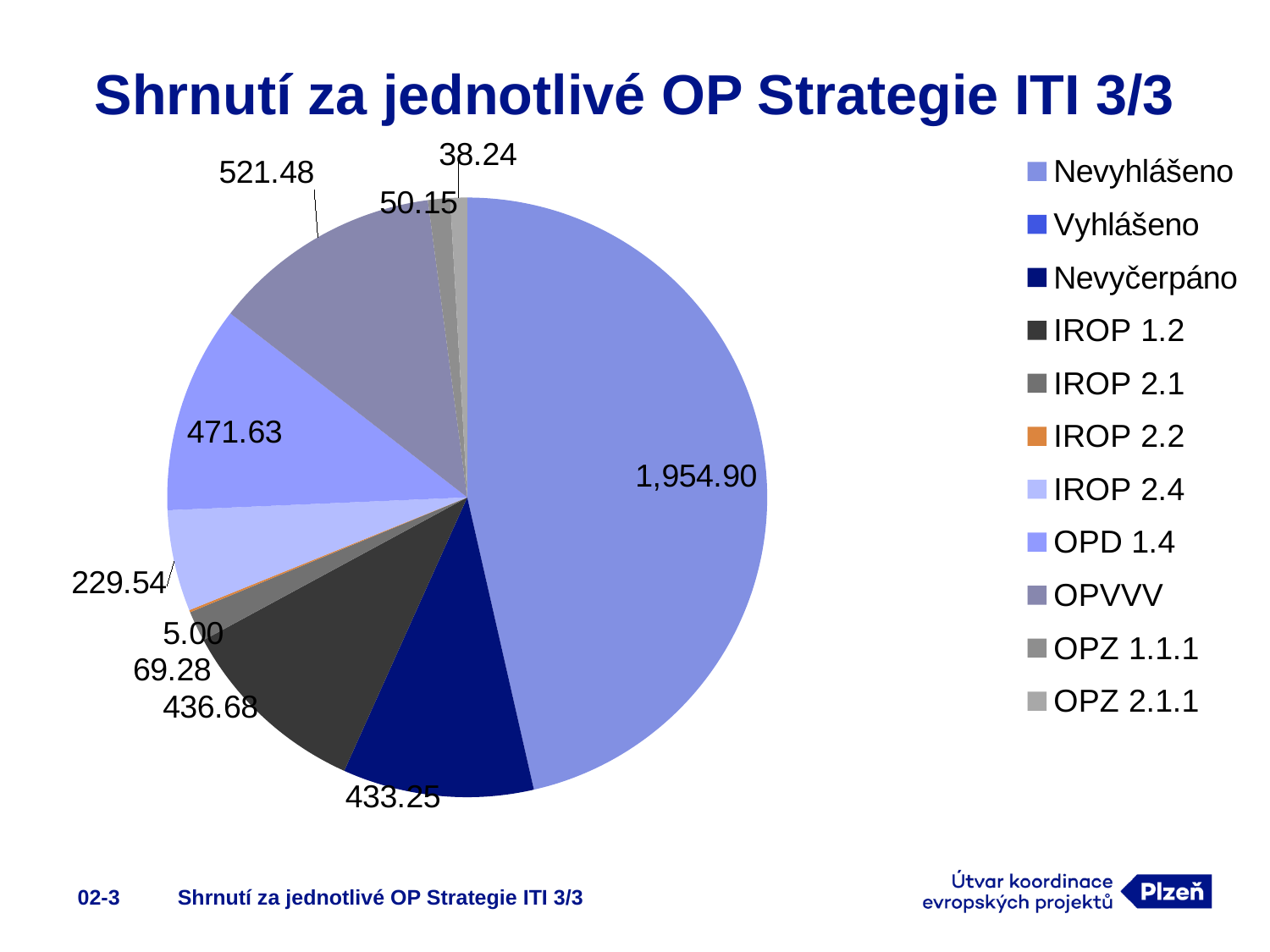
What is the difference between the OPVVV value and the OPD 1.4 value? 49.85 What is the value of the Nevyhlášeno slice? 1,954.90 Which is larger, the IROP 2.4 slice or the IROP 2.1 slice? IROP 2.4 What is the value of the IROP 2.4 slice? 229.54 How many entries does the chart legend list? 11 What is the value of the OPZ 2.1.1 slice? 38.24 What is the value of the OPVVV slice? 521.48 What kind of chart is shown on the slide? pie chart What is the title of the chart on the slide? Shrnutí za jednotlivé OP Strategie ITI 3/3 Which category has the largest slice of the pie? Nevyhlášeno What is the value of the OPD 1.4 slice? 471.63 Which labelled slice has the smallest value? IROP 2.2